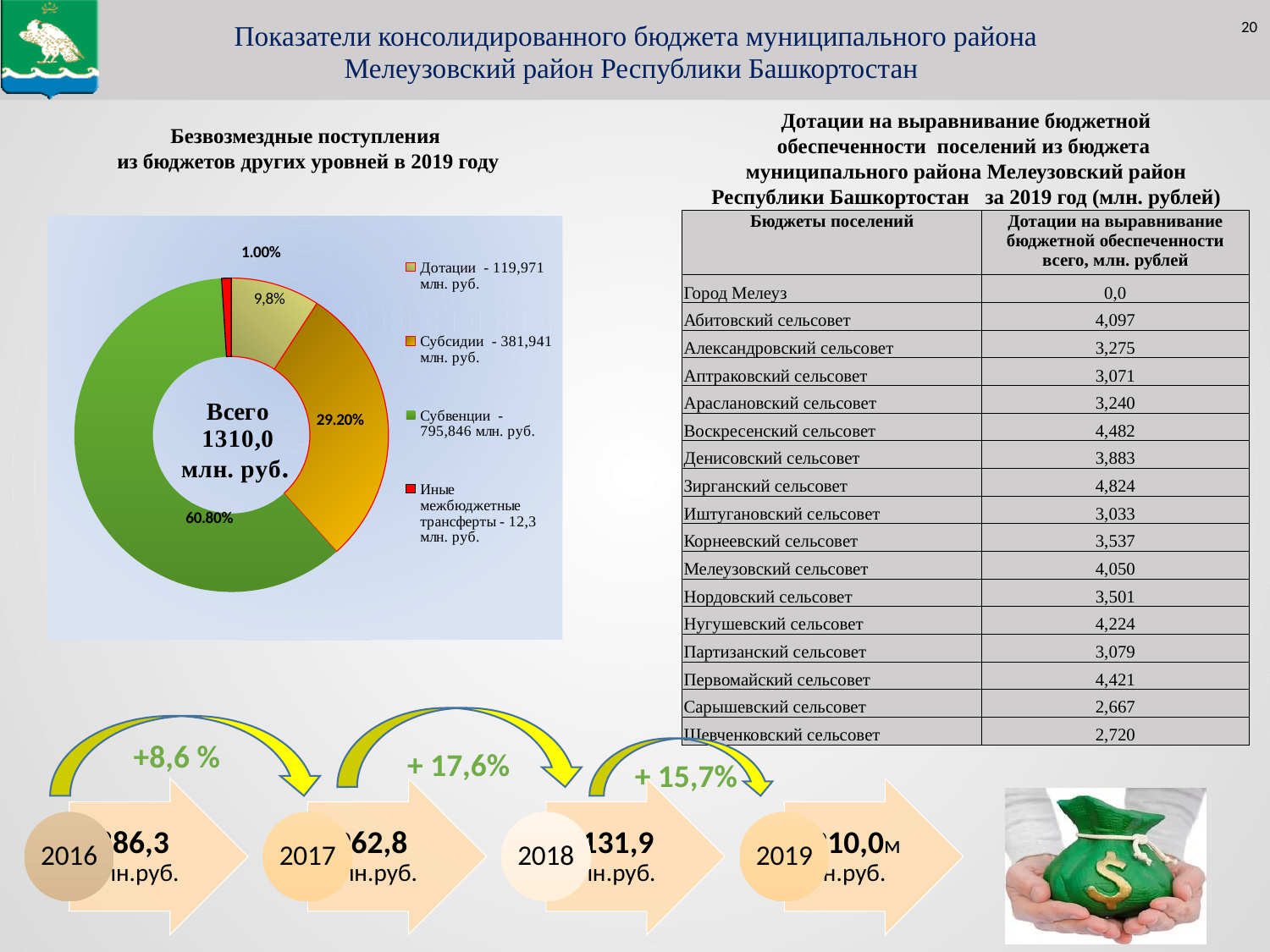
What total is printed in the centre of the doughnut chart? Всего 1310,0 млн. руб. What share of the doughnut chart do Субсидии make up? 29.20% According to the legend of the doughnut chart, what is the value for Дотации? 119,971 млн. руб. Which category has the largest slice in the doughnut chart? Субвенции How many entries does the legend of the doughnut chart list? 4 In the doughnut chart, which is larger: Дотации or Субсидии? Субсидии According to the legend of the doughnut chart, what is the value for Субвенции? 795,846 млн. руб. What share of the doughnut chart do Субвенции make up? 60.80% What kind of chart is shown under the title «Безвозмездные поступления из бюджетов других уровней в 2019 году»? doughnut (pie) chart Which category has the smallest slice in the doughnut chart? Иные межбюджетные трансферты According to the legend of the doughnut chart, what is the value for Субсидии? 381,941 млн. руб. How many slices does the doughnut chart «Безвозмездные поступления» have? 4